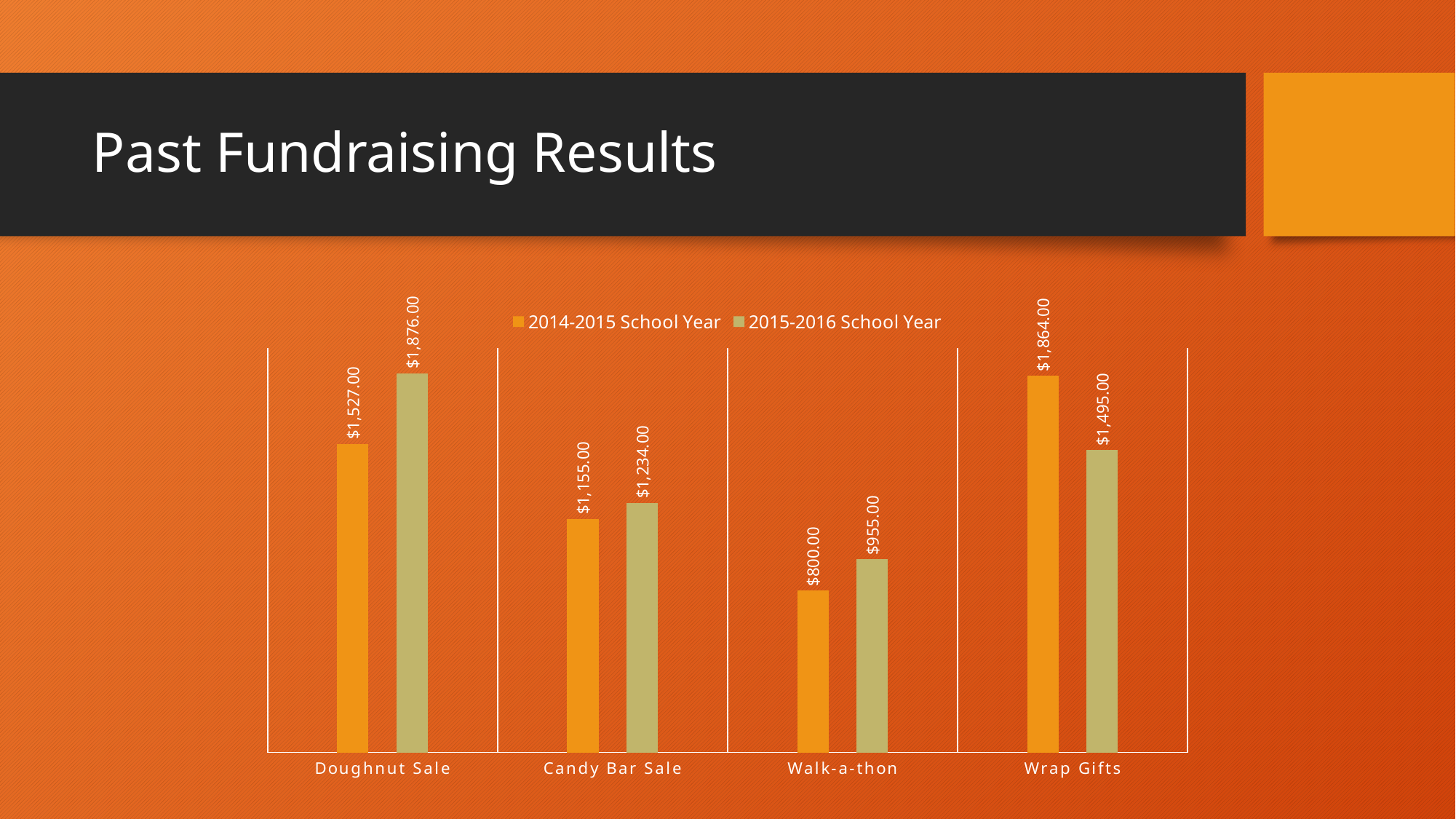
What kind of chart is shown on the slide? Bar chart What was the value for Doughnut Sale in the 2014-2015 School Year? $1,527.00 How many series does the legend list? 2 What is the difference between the 2015-2016 and 2014-2015 School Year values for Candy Bar Sale? $79.00 Which fundraiser had the highest value in the 2015-2016 School Year? Doughnut Sale What is the difference between the 2014-2015 and 2015-2016 School Year values for Wrap Gifts? $369.00 What is the title of the slide containing the chart? Past Fundraising Results What was the value for Wrap Gifts in the 2014-2015 School Year? $1,864.00 Which is larger for Doughnut Sale: the 2014-2015 School Year value or the 2015-2016 School Year value? 2015-2016 School Year What was the value for Walk-a-thon in the 2015-2016 School Year? $955.00 How many fundraiser categories are shown on the chart? 4 Which fundraiser had the lowest value in the 2014-2015 School Year? Walk-a-thon